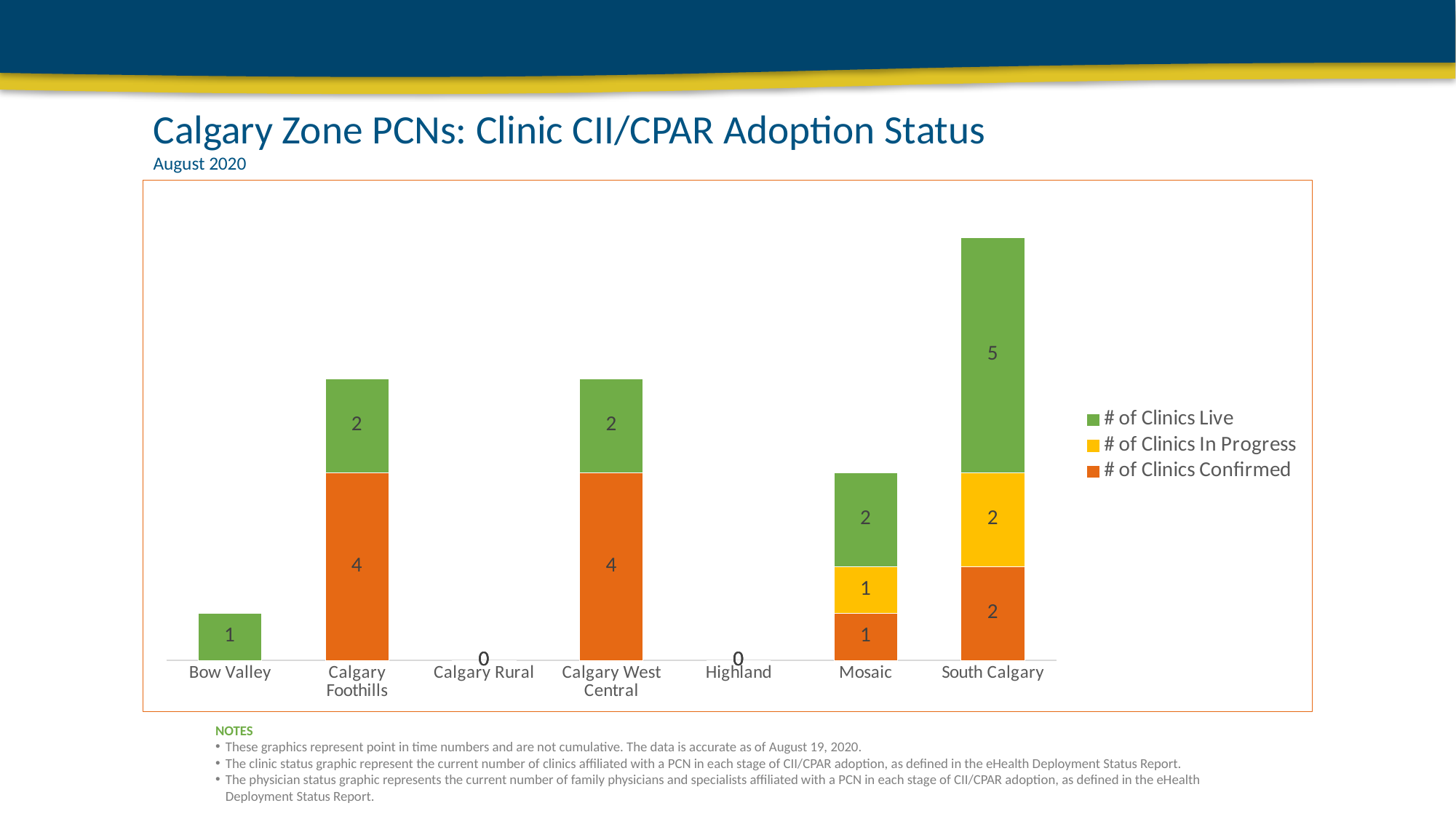
What is the number of Clinics In Progress for Mosaic? 1 What is the total number of clinics in the stacked bar for South Calgary? 9 What is the total number of clinics in the stacked bar for Mosaic? 4 Which colour represents '# of Clinics In Progress' in the legend? Yellow How many PCN categories are shown on the x axis? 7 What is the number of Clinics Live for South Calgary? 5 What is the number of Clinics Confirmed for Calgary Foothills? 4 What kind of chart is shown on the slide? Stacked bar chart Which has more Clinics Confirmed, Calgary West Central or South Calgary? Calgary West Central Which PCN has the highest total number of clinics? South Calgary How many series does the legend list? 3 What is the difference between the number of Clinics Live for South Calgary and for Mosaic? 3